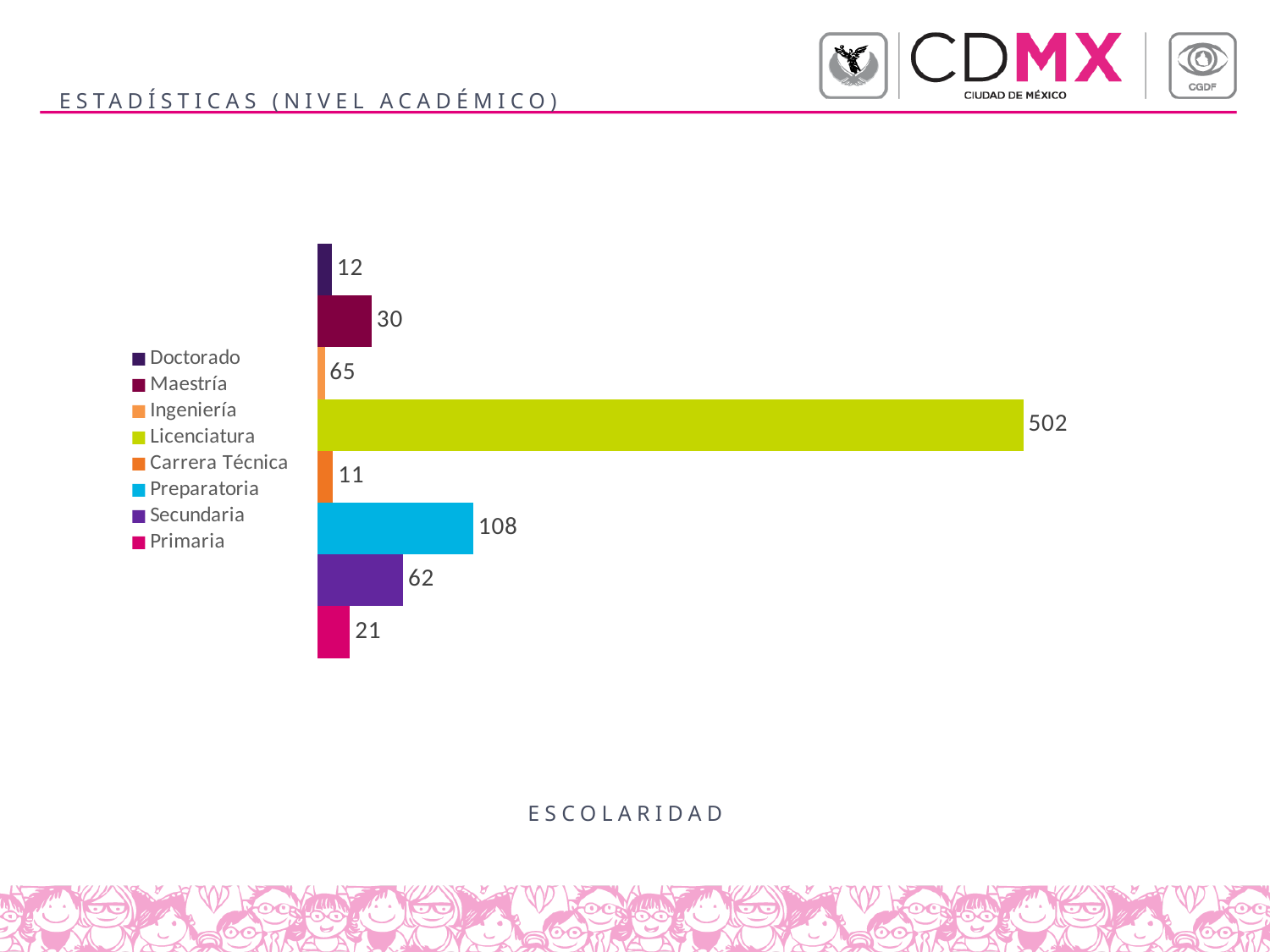
Which category has the lowest value? Carrera Técnica How many bars are plotted in the chart? 8 What value is shown for Preparatoria? 108 What kind of chart is shown on the slide? Bar chart What is the difference between the values for Secundaria and Primaria? 41 What value is shown for Primaria? 21 How many entries does the legend list? 8 What is the difference between the values for Licenciatura and Preparatoria? 394 Which is larger, the value for Maestría or the value for Secundaria? Secundaria What value is shown for Doctorado? 12 What value is shown for Licenciatura? 502 Which category has the highest value? Licenciatura